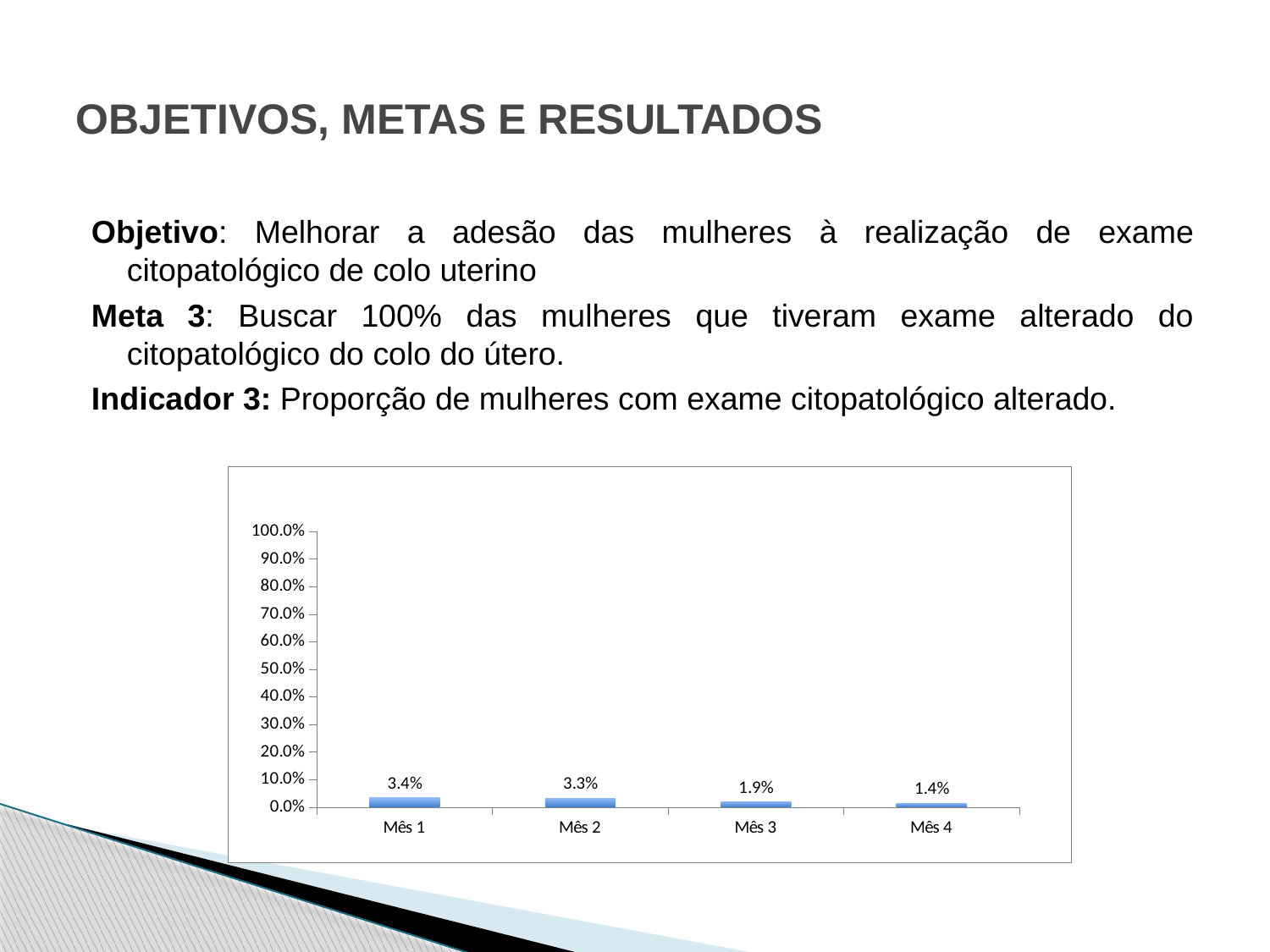
What is the value for Mês 2? 3.3% What is the difference between the values for Mês 1 and Mês 4? 2.0% What is the value for Mês 4? 1.4% What is the value for Mês 1? 3.4% Which month has the highest value? Mês 1 Is the value for Mês 1 greater or less than 10.0%? less Which month has the lowest value? Mês 4 What kind of chart is shown on the slide? bar chart Which is larger, the value for Mês 3 or the value for Mês 4? Mês 3 What is the value for Mês 3? 1.9% How many months are shown on the x axis? 4 What is the difference between the values for Mês 2 and Mês 3? 1.4%